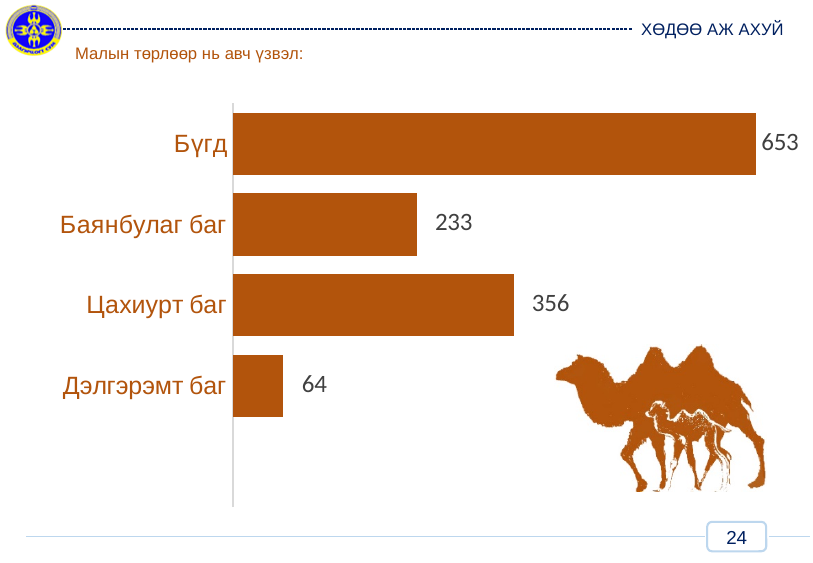
What is the value for Бүгд? 653 What is the value for Цахиурт баг? 356 Which category has the highest value? Бүгд What kind of chart is shown on the slide? Bar chart What is the value for Баянбулаг баг? 233 What is the difference between the values for Бүгд and Дэлгэрэмт баг? 589 Which is larger, the value for Баянбулаг баг or the value for Цахиурт баг? Цахиурт баг What is the value for Дэлгэрэмт баг? 64 How many categories are shown in the chart? 4 Which category has the lowest value? Дэлгэрэмт баг What colour are the bars in the chart? Orange-brown What is the difference between the values for Цахиурт баг and Баянбулаг баг? 123